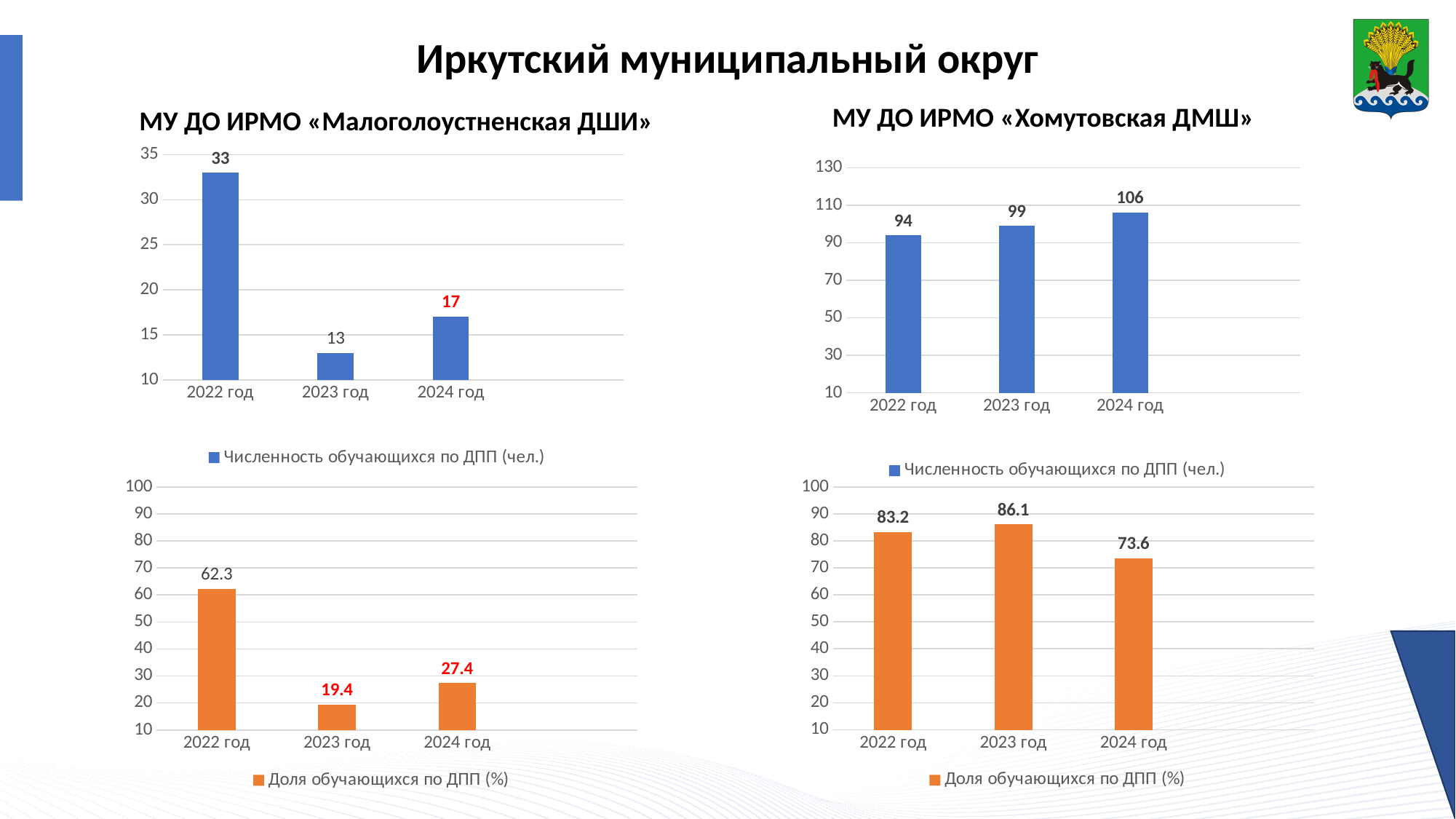
In the bottom-left chart (Доля обучающихся по ДПП for МУ ДО ИРМО «Малоголоустненская ДШИ»), which year has the highest value? 2022 год How many years (categories) are shown in the bottom-right chart (Доля обучающихся по ДПП for МУ ДО ИРМО «Хомутовская ДМШ»)? 3 In the top-left chart (Численность обучающихся по ДПП for МУ ДО ИРМО «Малоголоустненская ДШИ»), what is the difference between the values for 2022 год and 2024 год? 16 In the top-left chart (Численность обучающихся по ДПП for МУ ДО ИРМО «Малоголоустненская ДШИ»), what is the value for 2022 год? 33 In the top-right chart (Численность обучающихся по ДПП for МУ ДО ИРМО «Хомутовская ДМШ»), what is the difference between the values for 2023 год and 2022 год? 5 In the top-right chart (Численность обучающихся по ДПП for МУ ДО ИРМО «Хомутовская ДМШ»), what is the value for 2024 год? 106 In the top-left chart (Численность обучающихся по ДПП for МУ ДО ИРМО «Малоголоустненская ДШИ»), which year has the lowest value? 2023 год In the bottom-right chart (Доля обучающихся по ДПП for МУ ДО ИРМО «Хомутовская ДМШ»), which is larger, the value for 2022 год or 2024 год? 2022 год In the bottom-left chart (Доля обучающихся по ДПП for МУ ДО ИРМО «Малоголоустненская ДШИ»), what is the value for 2023 год? 19.4 What type of chart is the top-left chart (Численность обучающихся по ДПП for МУ ДО ИРМО «Малоголоустненская ДШИ»)? bar chart In the bottom-right chart (Доля обучающихся по ДПП for МУ ДО ИРМО «Хомутовская ДМШ»), what is the value for 2023 год? 86.1 In the top-right chart (Численность обучающихся по ДПП for МУ ДО ИРМО «Хомутовская ДМШ»), do the values rise or fall from 2022 год to 2024 год? rise